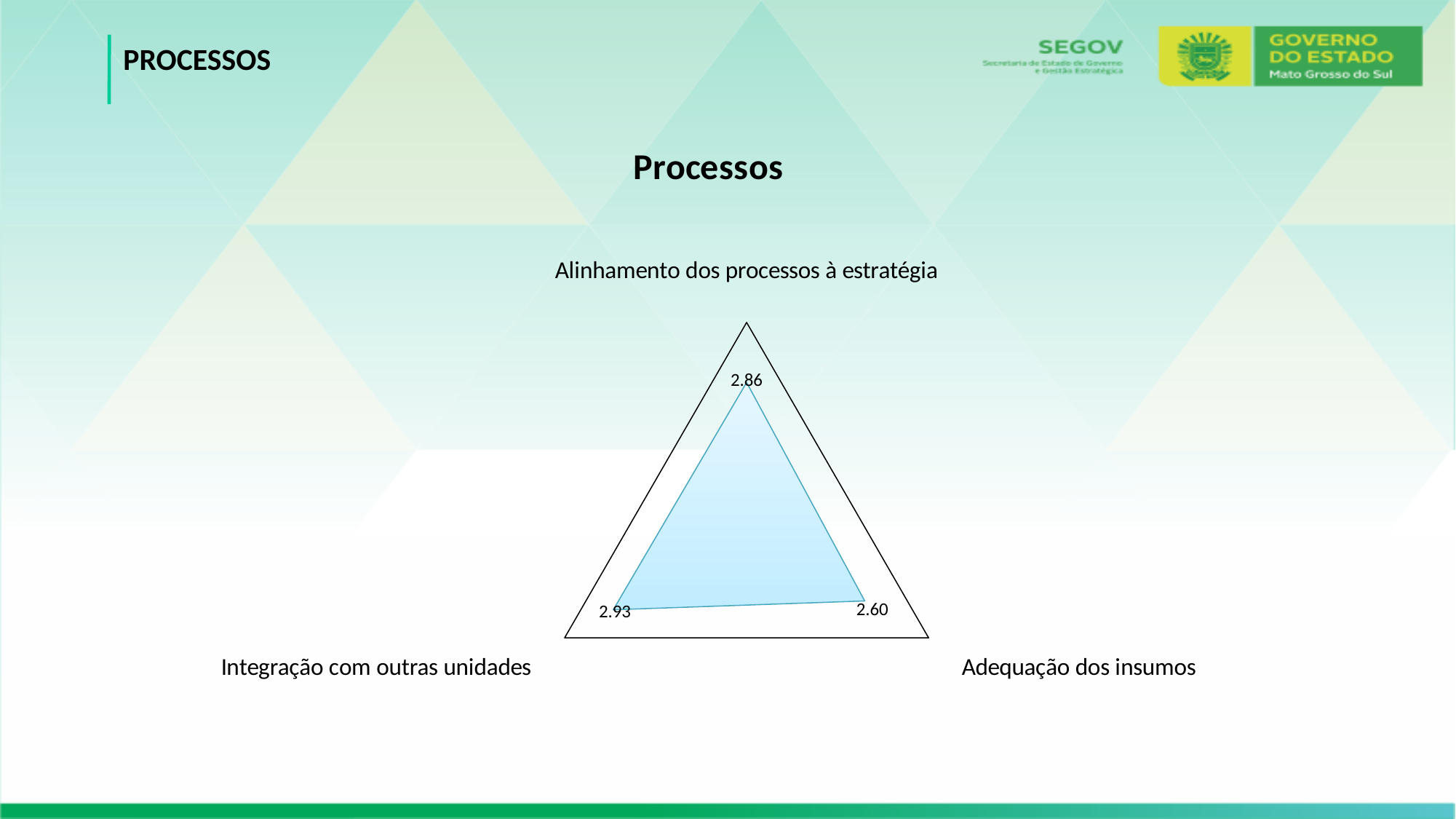
What is the difference between the values for Integração com outras unidades and Adequação dos insumos? 0.33 What is the value for Adequação dos insumos? 2.60 Which is larger, the value for Integração com outras unidades or the value for Alinhamento dos processos à estratégia? Integração com outras unidades Which category has the highest value? Integração com outras unidades Which is larger, the value for Alinhamento dos processos à estratégia or the value for Adequação dos insumos? Alinhamento dos processos à estratégia How many categories does the chart show? 3 What is the value for Integração com outras unidades? 2.93 Which category has the lowest value? Adequação dos insumos What is the difference between the values for Alinhamento dos processos à estratégia and Adequação dos insumos? 0.26 What is the title of the chart? Processos What is the value for Alinhamento dos processos à estratégia? 2.86 What kind of chart is shown on the slide? Radar chart